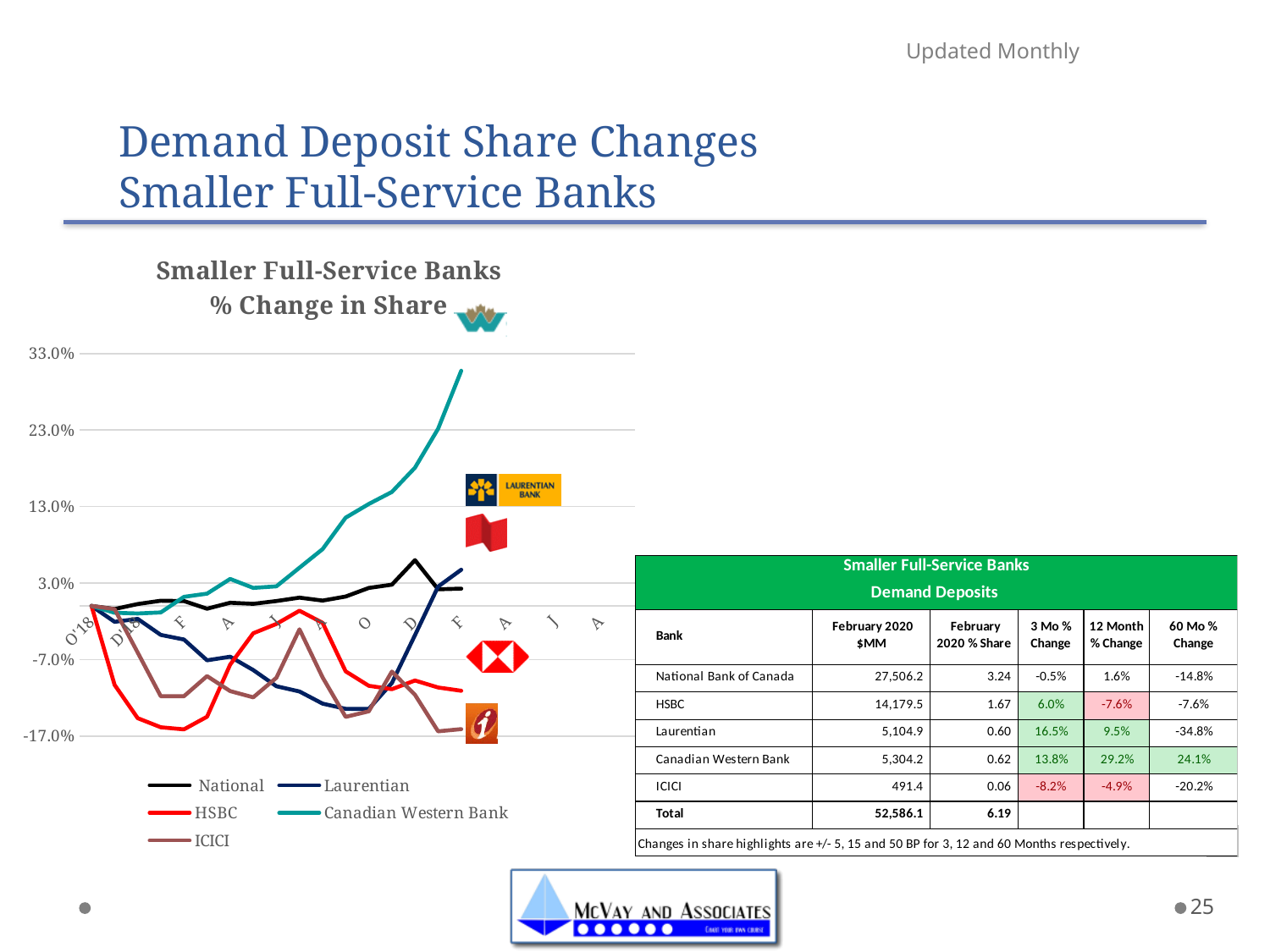
Which bank's line is drawn in red on the chart? HSBC Does the ICICI line generally rise or fall from left to right? Fall What is the title of the chart? Smaller Full-Service Banks % Change in Share Which series has the highest value at the right end of the chart? Canadian Western Bank At the right end of the chart, which is larger: the value for Canadian Western Bank or the value for National? Canadian Western Bank Does the Canadian Western Bank line generally rise or fall from left to right? Rise Is the final value for Canadian Western Bank greater or less than 23.0%? greater What kind of chart is shown on the slide? Line chart Is the final value for ICICI greater or less than -7.0%? less Which series has the lowest value at the right end of the chart? ICICI How many series does the legend of the chart list? 5 Is the final value for HSBC greater or less than -7.0%? less